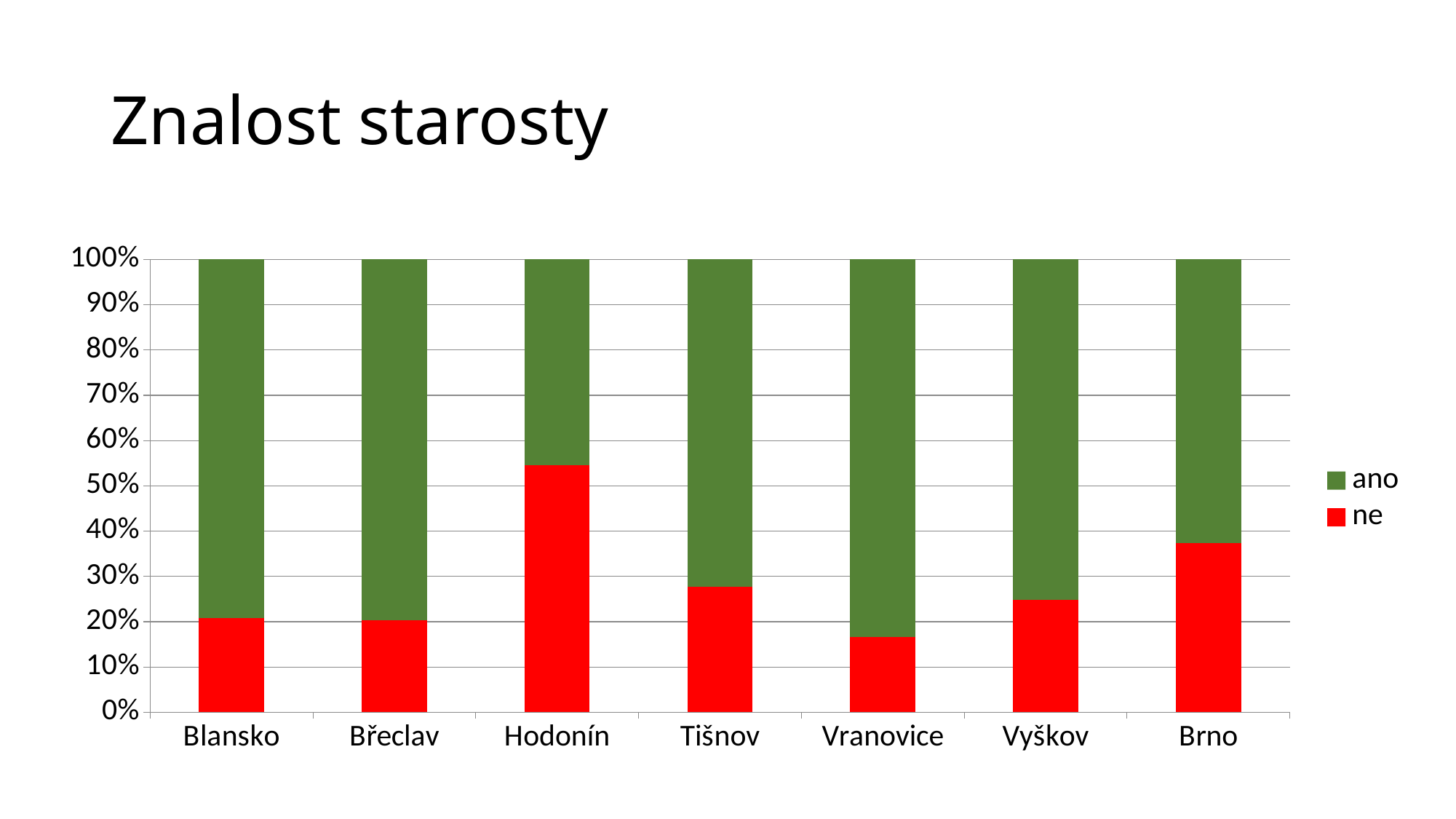
Is the "ne" value for Vranovice greater or less than 20%? less Which colour represents the series "ne" in the chart? Red What is the title of the chart? Znalost starosty Which town has the highest share of "ne"? Hodonín Is the "ne" value for Hodonín greater or less than 50%? greater What kind of chart is shown on the slide? Stacked bar chart How many series does the legend list? 2 What is the total of the stacked bar for Blansko? 100% How many towns are shown on the x axis of the chart? 7 Is the "ano" value for Brno greater or less than 70%? less Which town has the lowest share of "ne"? Vranovice Which town has a larger share of "ne", Brno or Tišnov? Brno